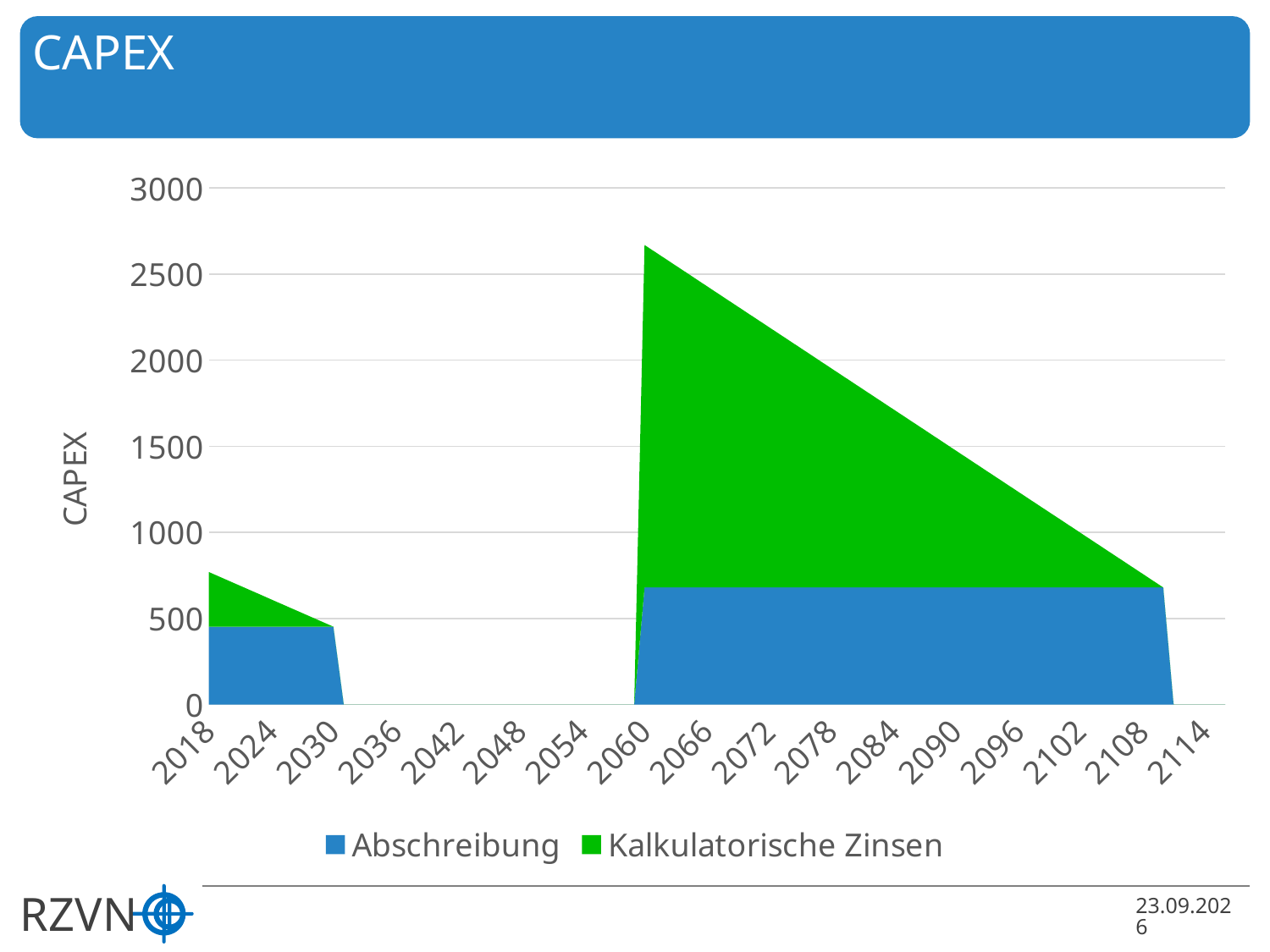
Is the stacked total in 2108 greater or less than 1000? less How many year labels are shown on the x axis? 17 What are the two series named in the legend? Abschreibung and Kalkulatorische Zinsen What kind of chart is shown on the slide? area chart Is the value for Abschreibung in 2090 greater or less than 1000? less What is the label on the vertical axis? CAPEX Which is larger, the stacked total in 2018 or in 2060? 2060 How many series does the legend list? 2 Is the value for Abschreibung in 2090 greater or less than 500? greater Between 2060 and 2108, does the stacked total rise or fall? fall In which year does the stacked total reach its highest point? 2060